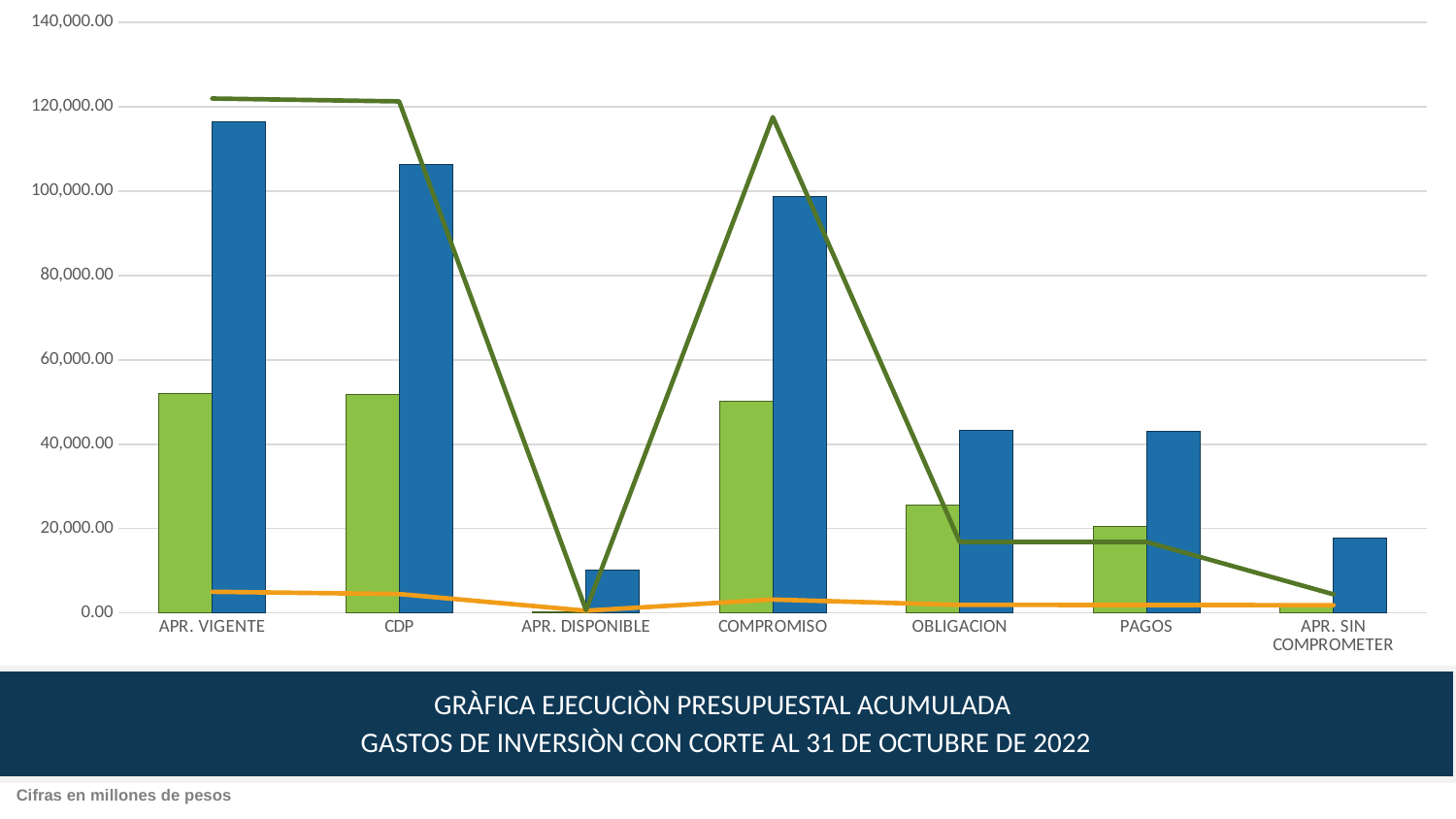
Which category has the tallest blue bar? APR. VIGENTE Is the green line value at COMPROMISO greater or less than 100,000.00? greater Which category has the lowest green bar? APR. DISPONIBLE Which is larger, the blue bar for APR. VIGENTE or the blue bar for CDP? APR. VIGENTE Is the green bar for OBLIGACION greater or less than 20,000.00? greater According to the note below the chart, in what units are the figures expressed? Millones de pesos Is the blue bar for APR. SIN COMPROMETER greater or less than 20,000.00? less What kind of chart is shown on the slide? A combined bar and line chart How many categories are shown on the x axis of the chart? 7 Which category has the shortest blue bar? APR. DISPONIBLE Does the green line rise or fall from COMPROMISO to APR. SIN COMPROMETER? fall